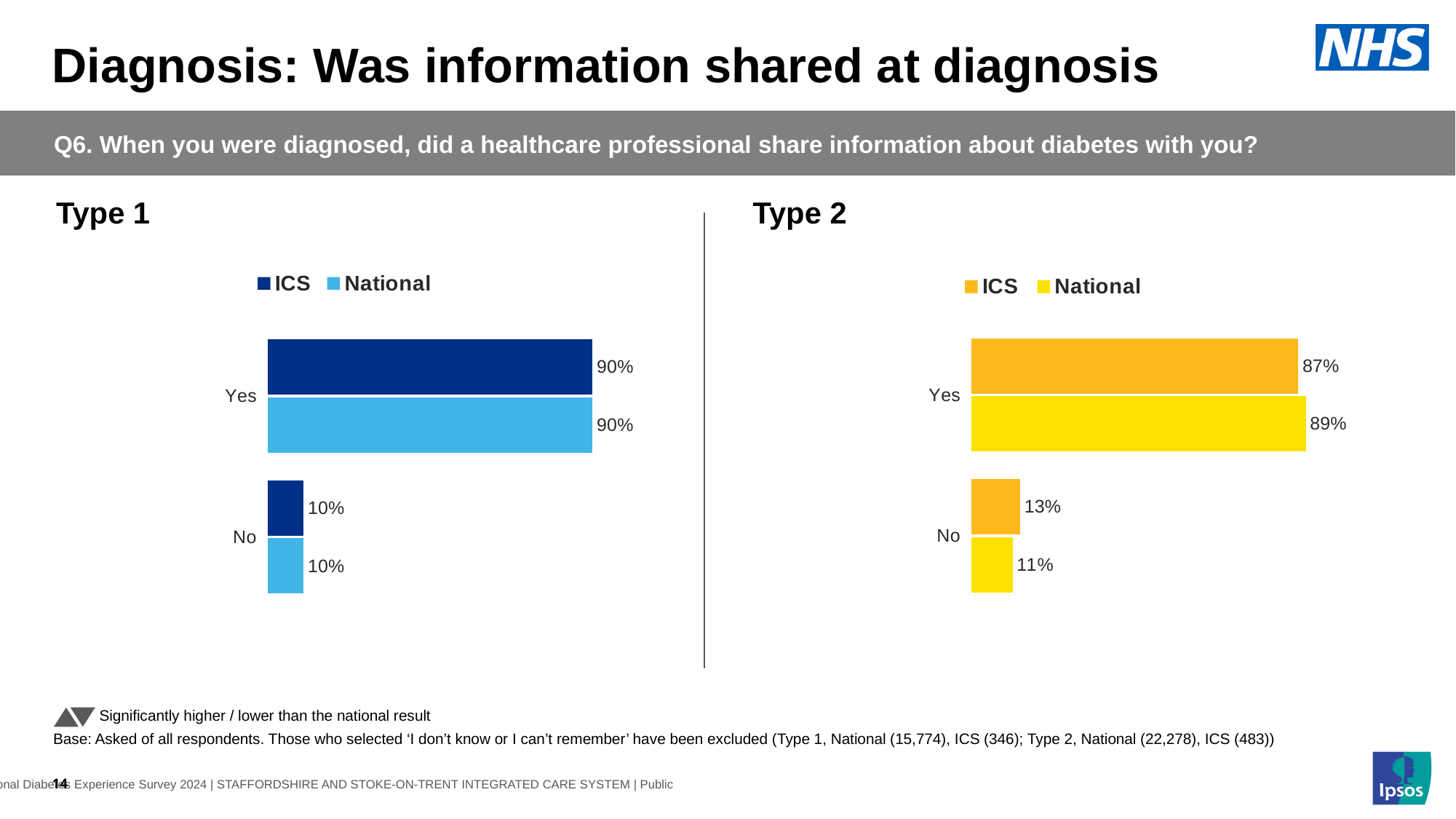
What kind of chart is the Type 1 chart? Bar chart In the Type 2 chart, what is the National value for Yes? 89% How many response categories are shown in the Type 1 chart? 2 How many series does the legend of the Type 2 chart list? 2 In the Type 1 chart, what is the ICS value for Yes? 90% In the Type 2 chart, what colour represents the National series? Yellow In the Type 2 chart, which is larger for Yes: ICS or National? National In the Type 1 chart, what is the National value for No? 10% In the Type 2 chart, what is the difference between the ICS and National values for No? 2% In the Type 2 chart, what is the ICS value for No? 13% In the Type 2 chart, what is the ICS value for Yes? 87% In the Type 2 chart, which response category has the highest ICS value? Yes